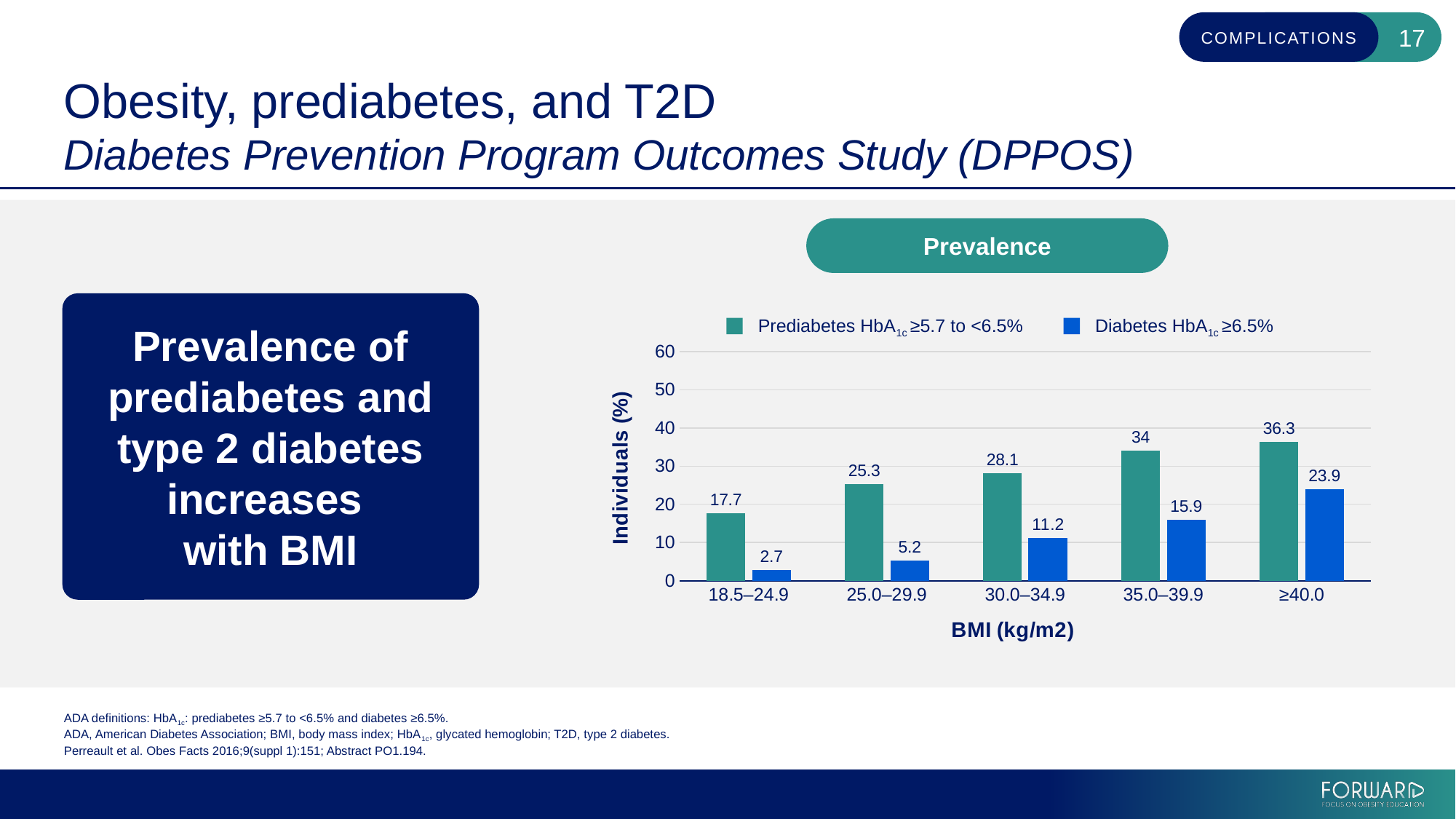
Which BMI category has the lowest prevalence of diabetes? 18.5–24.9 Does the prevalence of diabetes rise or fall as BMI increases along the x axis? Rise Which is larger: the prediabetes prevalence for BMI 25.0–29.9 or the diabetes prevalence for BMI ≥40.0? Prediabetes prevalence for BMI 25.0–29.9 What is the difference between the prediabetes and diabetes prevalence in the 35.0–39.9 BMI category? 18.1 What is the prevalence of diabetes for the BMI category ≥40.0? 23.9 What is the prevalence of prediabetes for the BMI category 30.0–34.9? 28.1 How many series does the legend list? 2 What is the prevalence of diabetes for the BMI category 18.5–24.9? 2.7 What is the label of the y axis? Individuals (%) Which BMI category has the highest prevalence of prediabetes? ≥40.0 How many BMI categories are shown on the x axis? 5 What kind of chart is shown on the slide? Bar chart